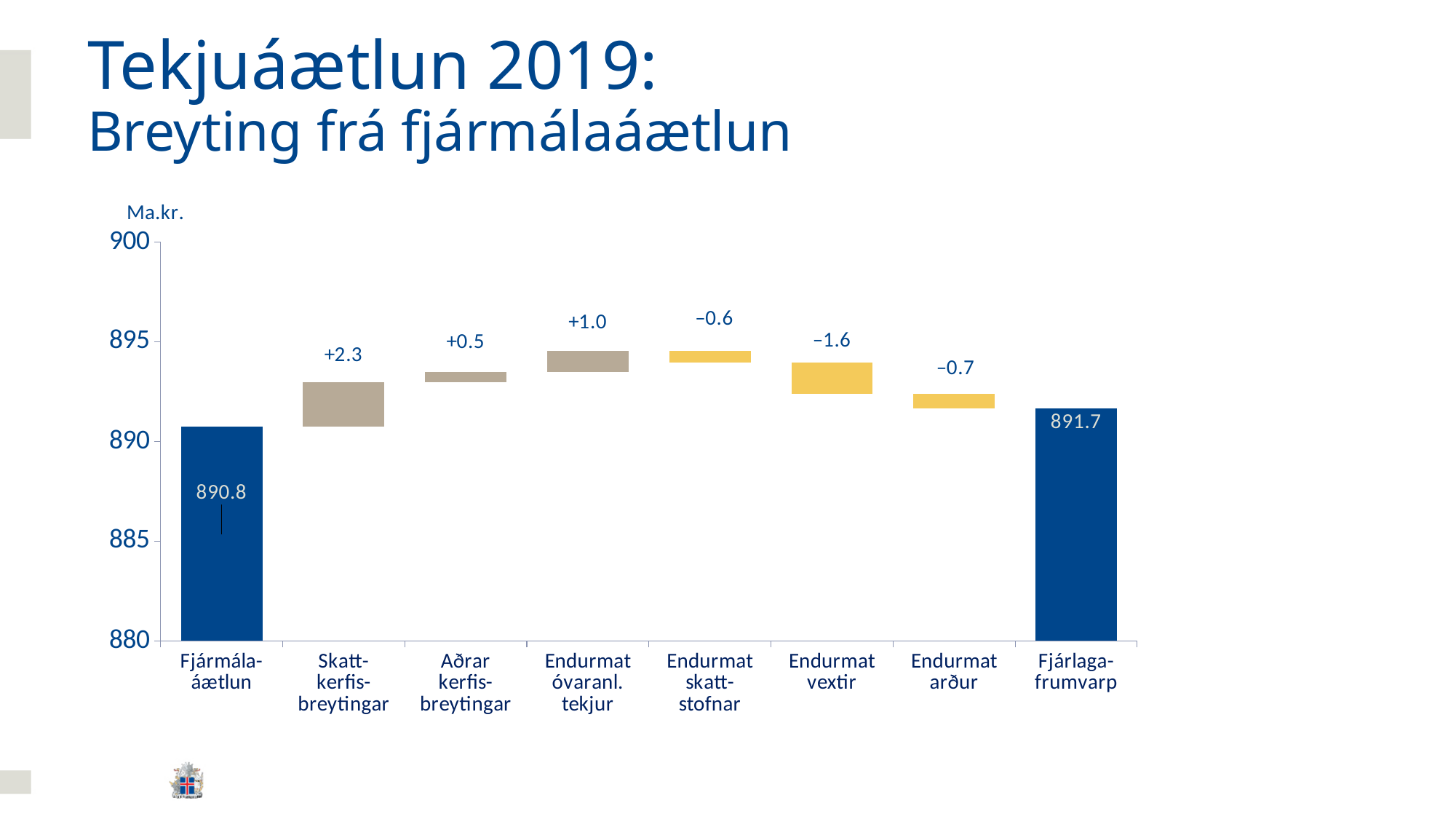
What is the value of the Fjárlagafrumvarp bar? 891.7 How many categories are shown on the x axis? 8 Which category shows the largest positive change? Skattkerfisbreytingar What kind of chart is shown on the slide? Bar chart (waterfall) What unit is shown above the y axis? Ma.kr. What change is shown for Endurmat vextir? –1.6 What change is shown for Endurmat óvaranl. tekjur? +1.0 Which is larger in magnitude, the change for Endurmat skattstofnar or the change for Endurmat arður? Endurmat arður What change is shown for Skattkerfisbreytingar? +2.3 Which category shows the largest negative change? Endurmat vextir What is the value of the Fjármálaáætlun bar? 890.8 What is the difference between the Fjárlagafrumvarp value and the Fjármálaáætlun value? 0.9